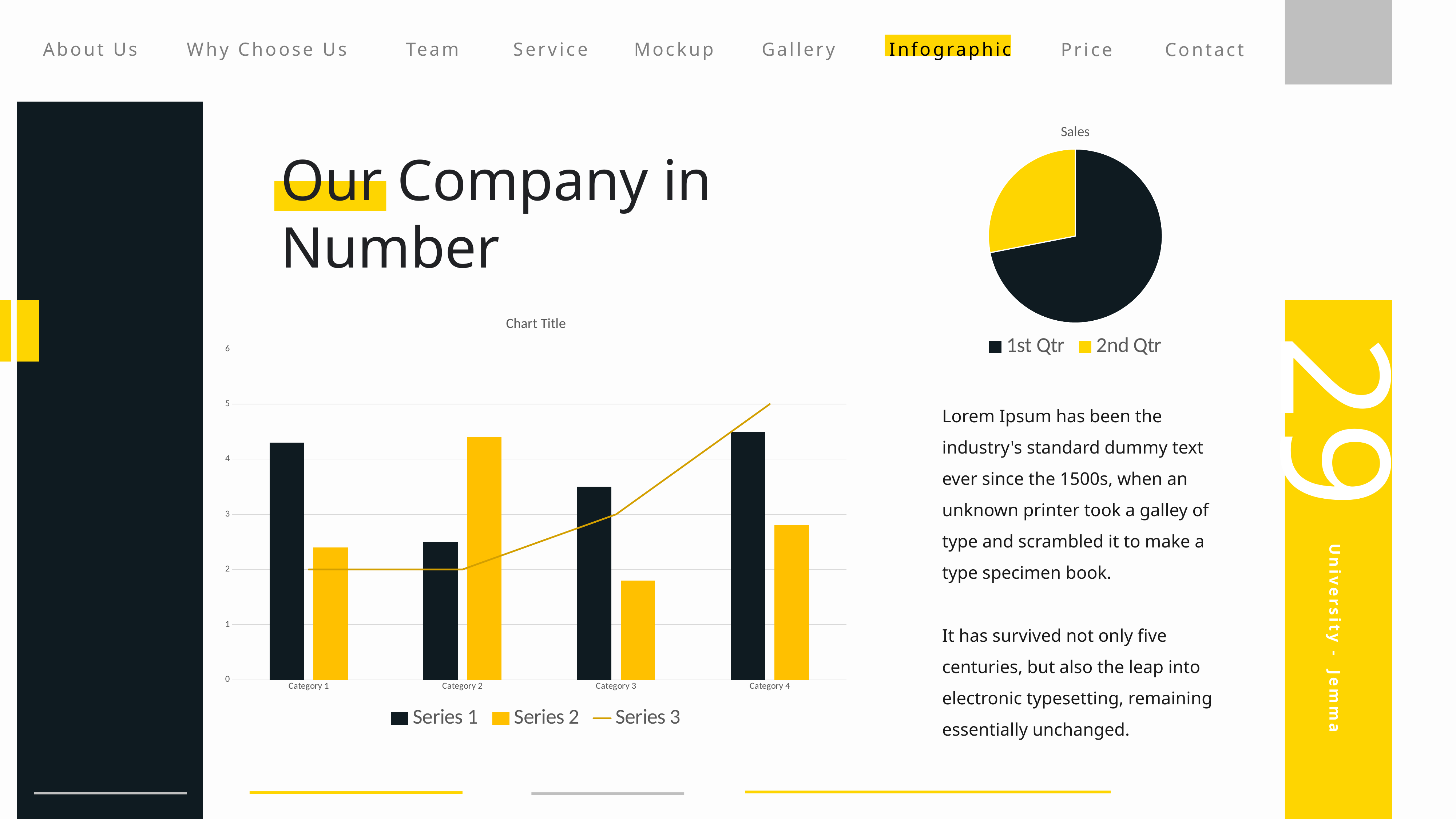
In the chart titled "Chart Title", what is the value of Series 3 at Category 4? 5 In the chart titled "Chart Title", which category has the highest value for Series 2? Category 2 In the chart titled "Chart Title", is the value of Series 2 for Category 3 greater or less than 2? less In the chart titled "Chart Title", is the value of Series 1 for Category 1 greater or less than 4? greater In the chart titled "Chart Title", how many categories are shown on the x axis? 4 In the chart titled "Sales", which slice is larger: 1st Qtr or 2nd Qtr? 1st Qtr In the chart titled "Chart Title", how many series does the legend list? 3 In the chart titled "Chart Title", for Category 2, which is larger: Series 1 or Series 2? Series 2 In the chart titled "Chart Title", does Series 3 rise or fall from Category 2 to Category 4? rise In the chart titled "Chart Title", which category has the lowest value for Series 1? Category 2 What kind of chart is the chart titled "Sales"? pie chart In the chart titled "Chart Title", what is the value of Series 3 at Category 3? 3